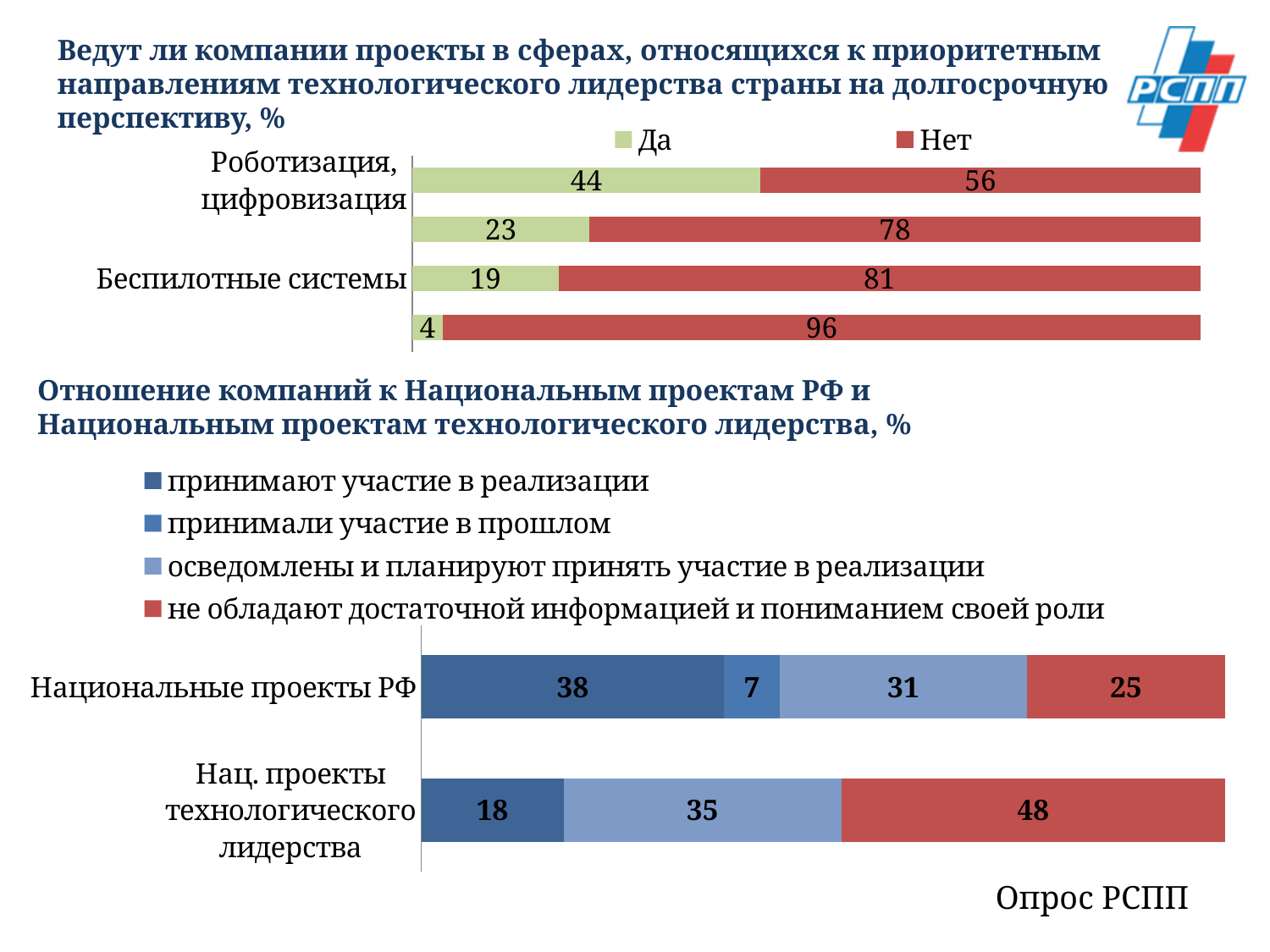
In the top chart, what is the 'Да' value for 'Беспилотные системы'? 19 In the top chart, which is larger for 'Беспилотные системы': 'Да' or 'Нет'? Нет In the top chart, what is the 'Нет' value for 'Беспилотные системы'? 81 What type of chart is the bottom chart? Stacked bar chart In the top chart, how many series does the legend list? 2 In the bottom chart, how many series does the legend list? 4 In the bottom chart, what is the value for 'принимают участие в реализации' for 'Национальные проекты РФ'? 38 In the bottom chart, what is the value for 'принимали участие в прошлом' for 'Национальные проекты РФ'? 7 In the top chart, what is the 'Да' value for 'Роботизация, цифровизация'? 44 In the top chart, what is the difference between the 'Нет' and 'Да' values for 'Роботизация, цифровизация'? 12 In the bottom chart, what is the total of the stacked bar for 'Национальные проекты РФ'? 101 In the bottom chart, what is the value for 'не обладают достаточной информацией и пониманием своей роли' for 'Нац. проекты технологического лидерства'? 48